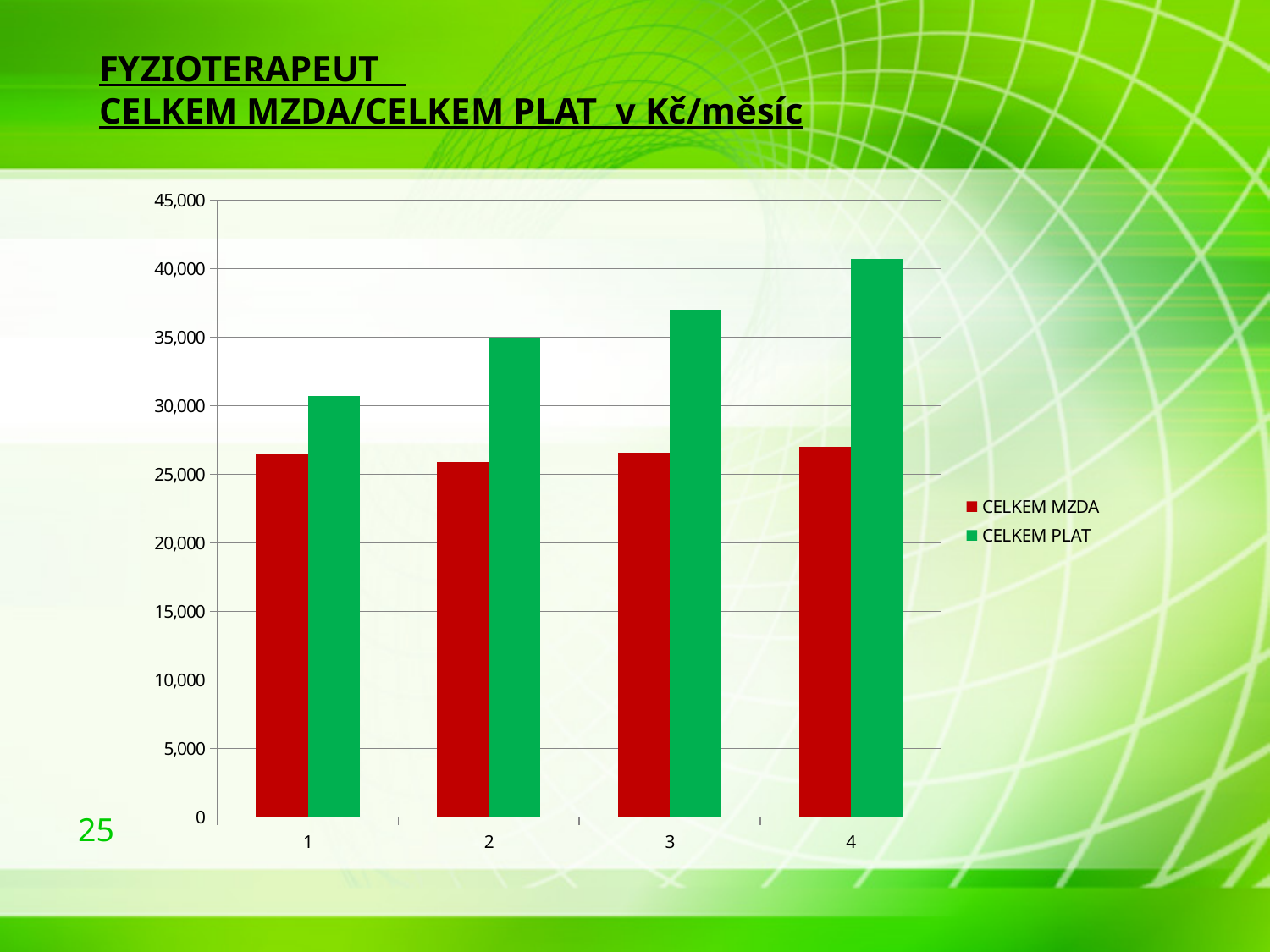
Do the CELKEM PLAT values rise or fall from category 1 to category 4? rise Which category has the highest value for CELKEM PLAT? 4 Which category has the lowest value for CELKEM PLAT? 1 Is the value for CELKEM MZDA in category 1 greater or less than 25,000? greater What colour are the CELKEM MZDA bars? red How many categories are shown on the x axis? 4 In category 1, which is larger: CELKEM MZDA or CELKEM PLAT? CELKEM PLAT How many series does the legend list? 2 Is the value for CELKEM PLAT in category 3 greater or less than 35,000? greater Is the value for CELKEM PLAT in category 4 greater or less than 40,000? greater What kind of chart is shown on the slide? bar chart